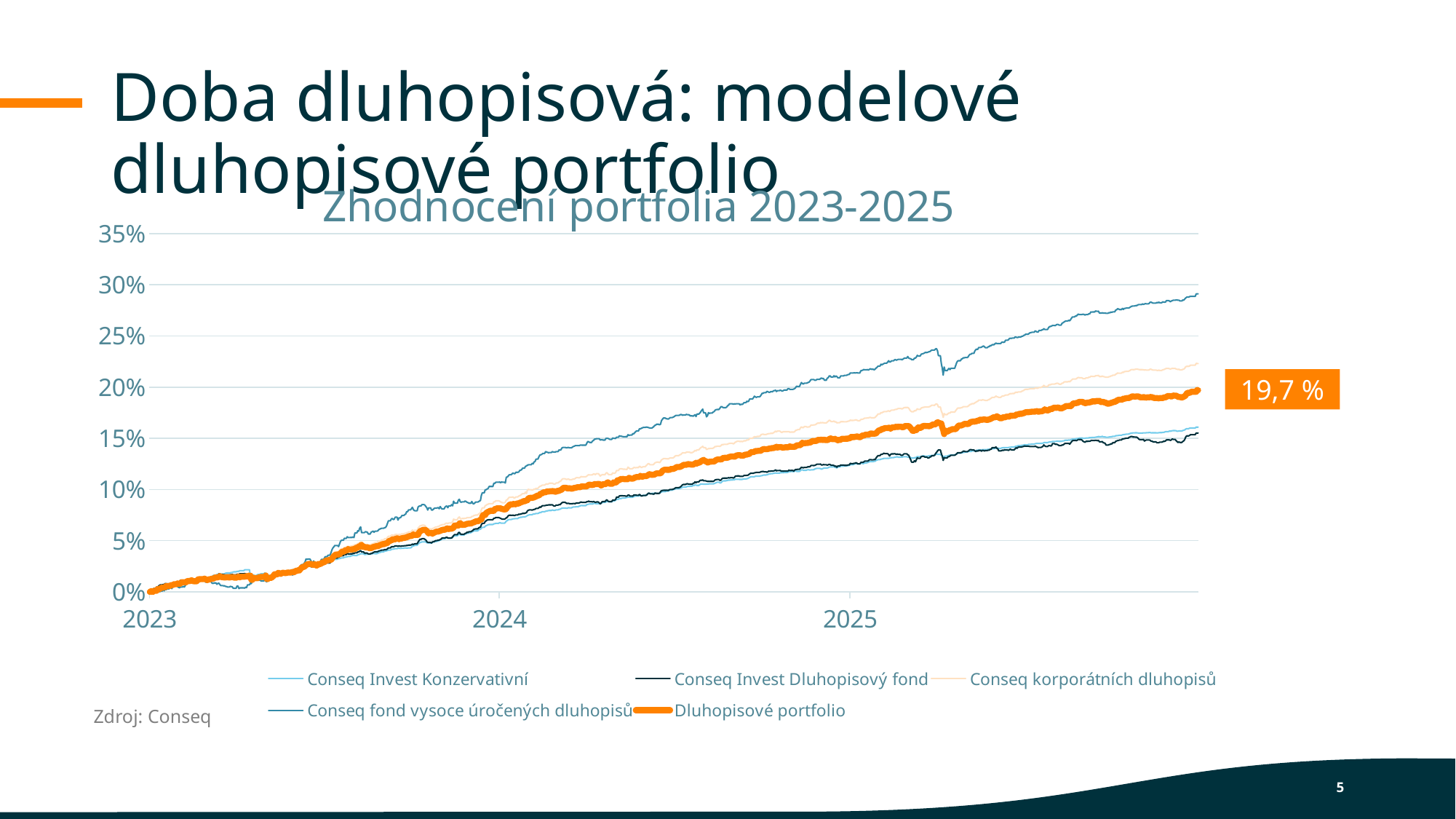
What is the title of the chart? Zhodnocení portfolia 2023-2025 What colour is the line for Dluhopisové portfolio? orange Is the final value for Conseq korporátních dluhopisů greater or less than 20%? greater Do the values of Dluhopisové portfolio rise or fall from 2023 to 2025? rise What kind of chart is shown on the slide? line chart How many series does the chart legend list? 5 Is the final value for Conseq Invest Konzervativní greater or less than 20%? less Is the final value for Conseq fond vysoce úročených dluhopisů greater or less than 25%? greater Which series ends at the highest value at the right end of the chart? Conseq fond vysoce úročených dluhopisů At the right end of the chart, which is higher: Conseq korporátních dluhopisů or Conseq Invest Dluhopisový fond? Conseq korporátních dluhopisů What is the final value shown for Dluhopisové portfolio? 19,7 % How many year labels are shown on the x axis? 3